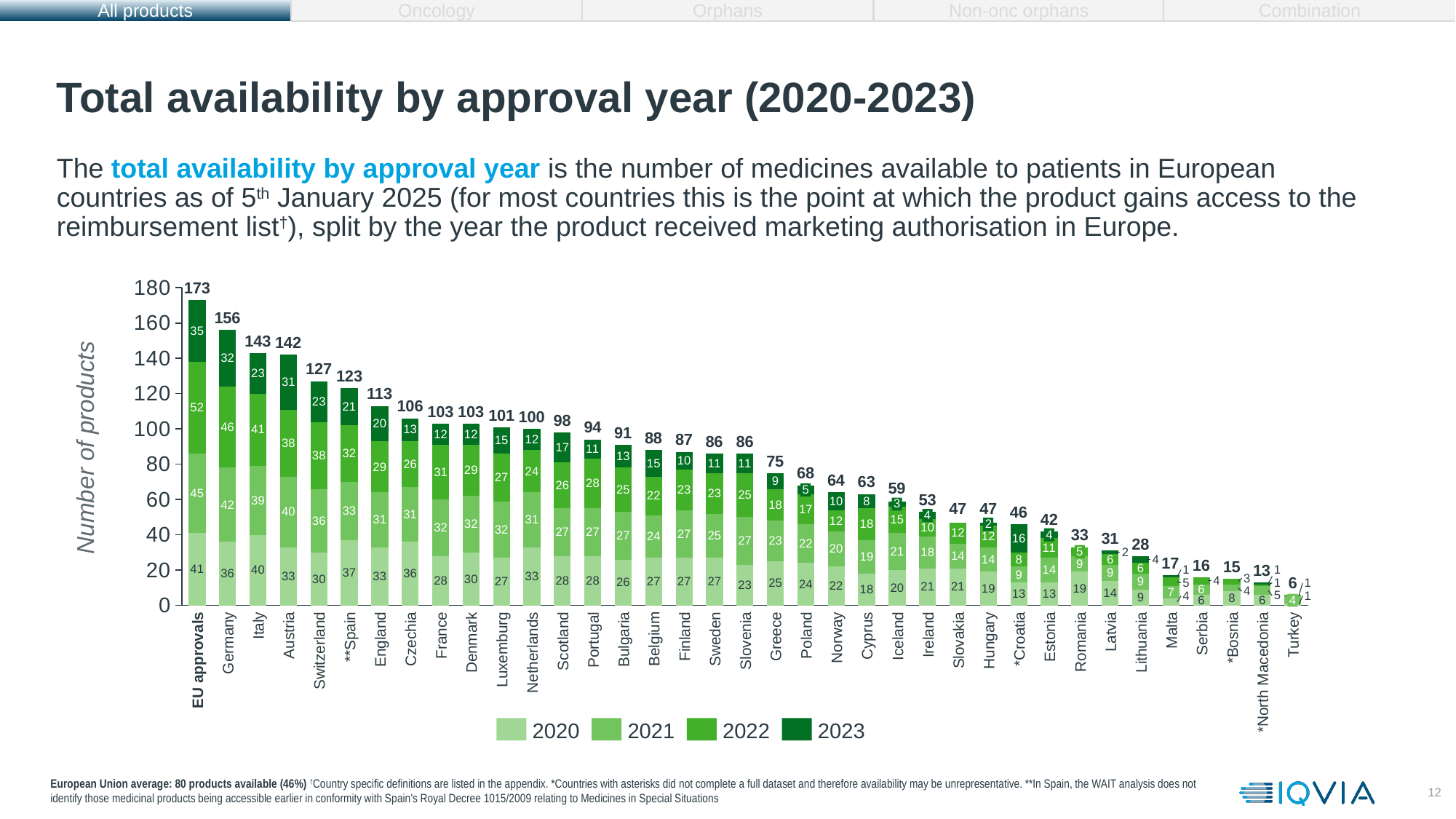
Do the bar totals rise or fall from left to right along the x axis? Fall What is the label of the y axis? Number of products Which country has the lowest total number of products? Turkey How many series does the legend list? 4 What is the 2020 segment value for Italy? 40 What kind of chart is shown? Stacked bar chart Which has a larger total, Greece or Poland? Greece What is the 2023 segment value for EU approvals? 35 What is the 2022 segment value for Germany? 46 Which bar has the highest total? EU approvals What is the total number of products for Germany? 156 What is the difference between the totals for Switzerland and **Spain? 4